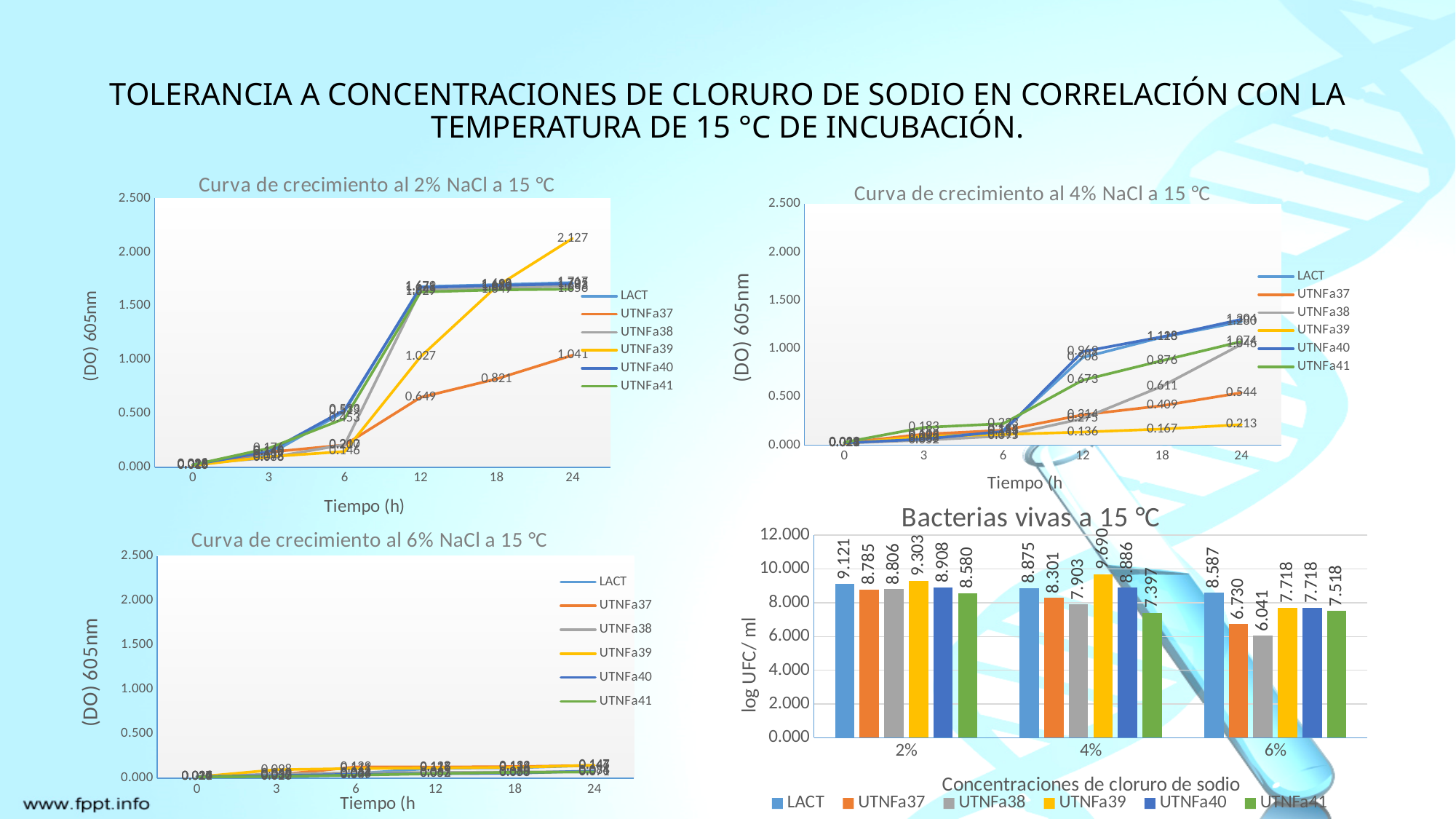
In the "Curva de crecimiento al 2% NaCl a 15 °C" chart, what is the value for UTNFa39 at 24 h? 2.127 In the "Curva de crecimiento al 2% NaCl a 15 °C" chart, what is the value for UTNFa37 at 18 h? 0.821 In the "Bacterias vivas a 15 °C" chart, what is the difference between the LACT value at 2% and the LACT value at 6%? 0.534 In the "Curva de crecimiento al 4% NaCl a 15 °C" chart, what is the value for UTNFa37 at 24 h? 0.544 In the "Bacterias vivas a 15 °C" chart, which series has the highest value at 2%? UTNFa39 How many concentration categories are shown on the x axis of the "Bacterias vivas a 15 °C" chart? 3 In the "Bacterias vivas a 15 °C" chart, which series has the lowest value at 6%? UTNFa38 How many series does the legend of the "Bacterias vivas a 15 °C" chart list? 6 What kind of chart is "Bacterias vivas a 15 °C"? bar chart In the "Curva de crecimiento al 6% NaCl a 15 °C" chart, is the value for UTNFa39 at 24 h greater or less than 0.500? less In the "Curva de crecimiento al 4% NaCl a 15 °C" chart, which is larger at 24 h: UTNFa37 or UTNFa39? UTNFa37 In the "Bacterias vivas a 15 °C" chart, what is the value for UTNFa39 at 4%? 9.690